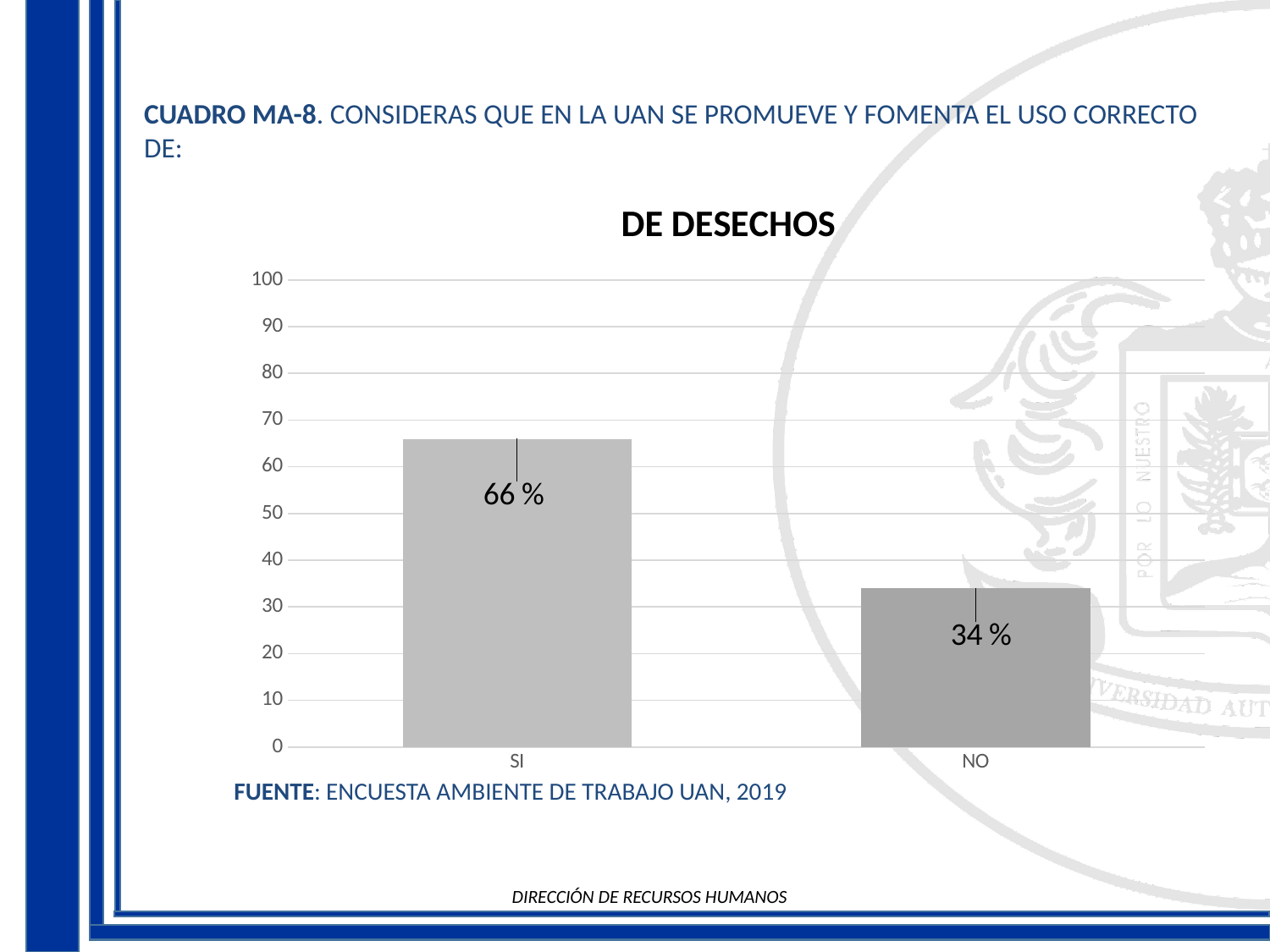
What is the maximum value shown on the vertical axis? 100 What is the value for SI? 66 % What is the value for NO? 34 % Which category has the highest value? SI What is the difference between the values for SI and NO? 32 % What kind of chart is shown on the slide? bar chart How many categories are shown on the x axis? 2 Is the value for SI greater or less than 60? greater What is the title of the chart? DE DESECHOS Which category has the lowest value? NO Is the value for NO greater or less than 40? less Which is larger, the value for SI or the value for NO? SI